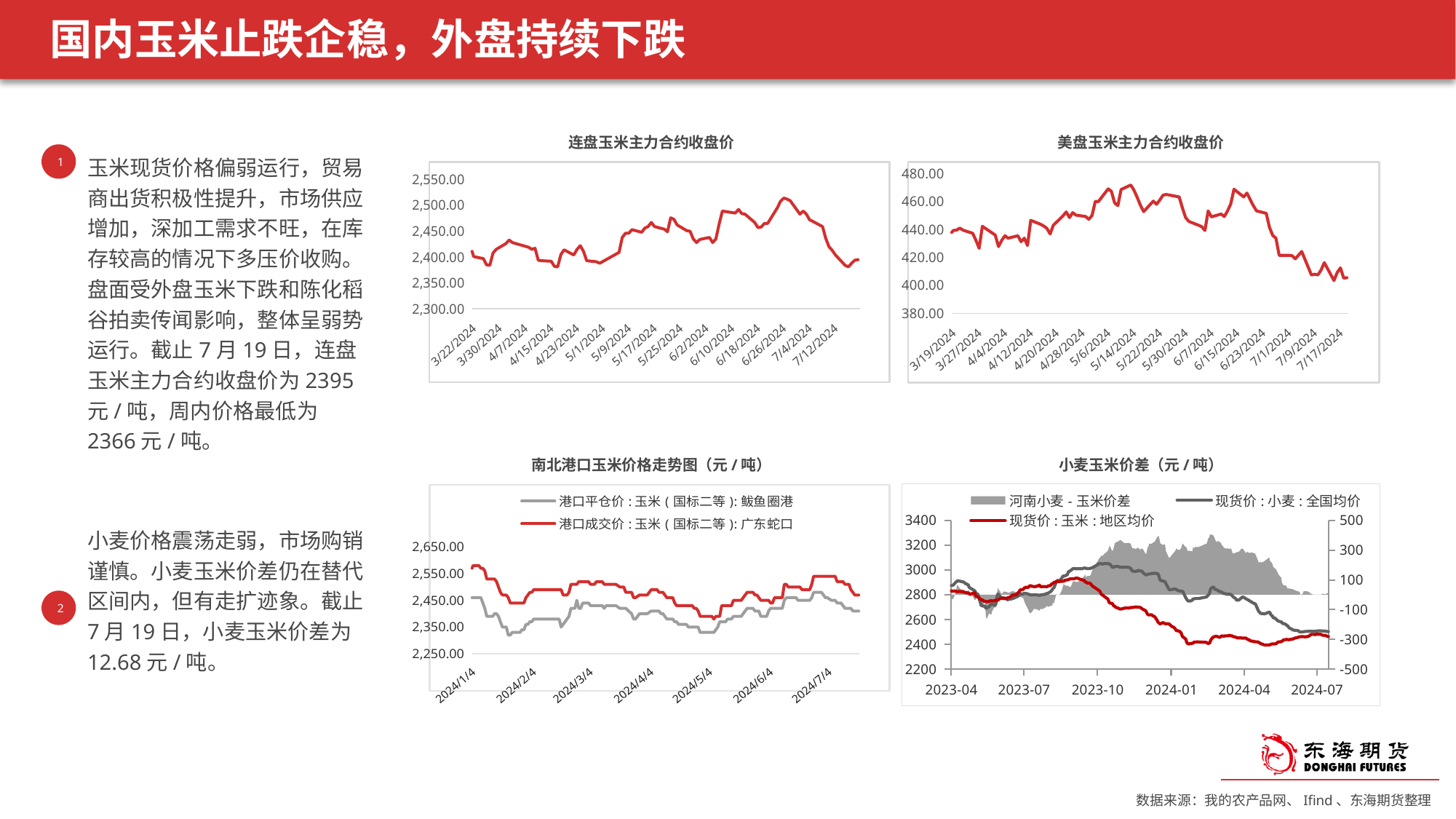
In the 美盘玉米主力合约收盘价 chart, is the last value (7/17/2024) greater or less than 420.00? less In the 南北港口玉米价格走势图（元/吨） chart, which series has the higher values throughout, 鲅鱼圈港 or 广东蛇口? 广东蛇口 In the 连盘玉米主力合约收盘价 chart, is the highest point greater or less than 2,450.00? greater In the 美盘玉米主力合约收盘价 chart, is the highest point greater or less than 460.00? greater What kind of chart is the 连盘玉米主力合约收盘价 chart? line chart In the 美盘玉米主力合约收盘价 chart, do values overall rise or fall from left to right along the x axis? fall In the 南北港口玉米价格走势图（元/吨） chart, what colour is the line for 港口成交价:玉米(国标二等):广东蛇口? red In the 小麦玉米价差（元/吨） chart, does the 现货价:玉米:地区均价 series overall rise or fall from 2023-10 to 2024-07? fall How many series does the legend of the 南北港口玉米价格走势图（元/吨） chart list? 2 How many series does the legend of the 小麦玉米价差（元/吨） chart list? 3